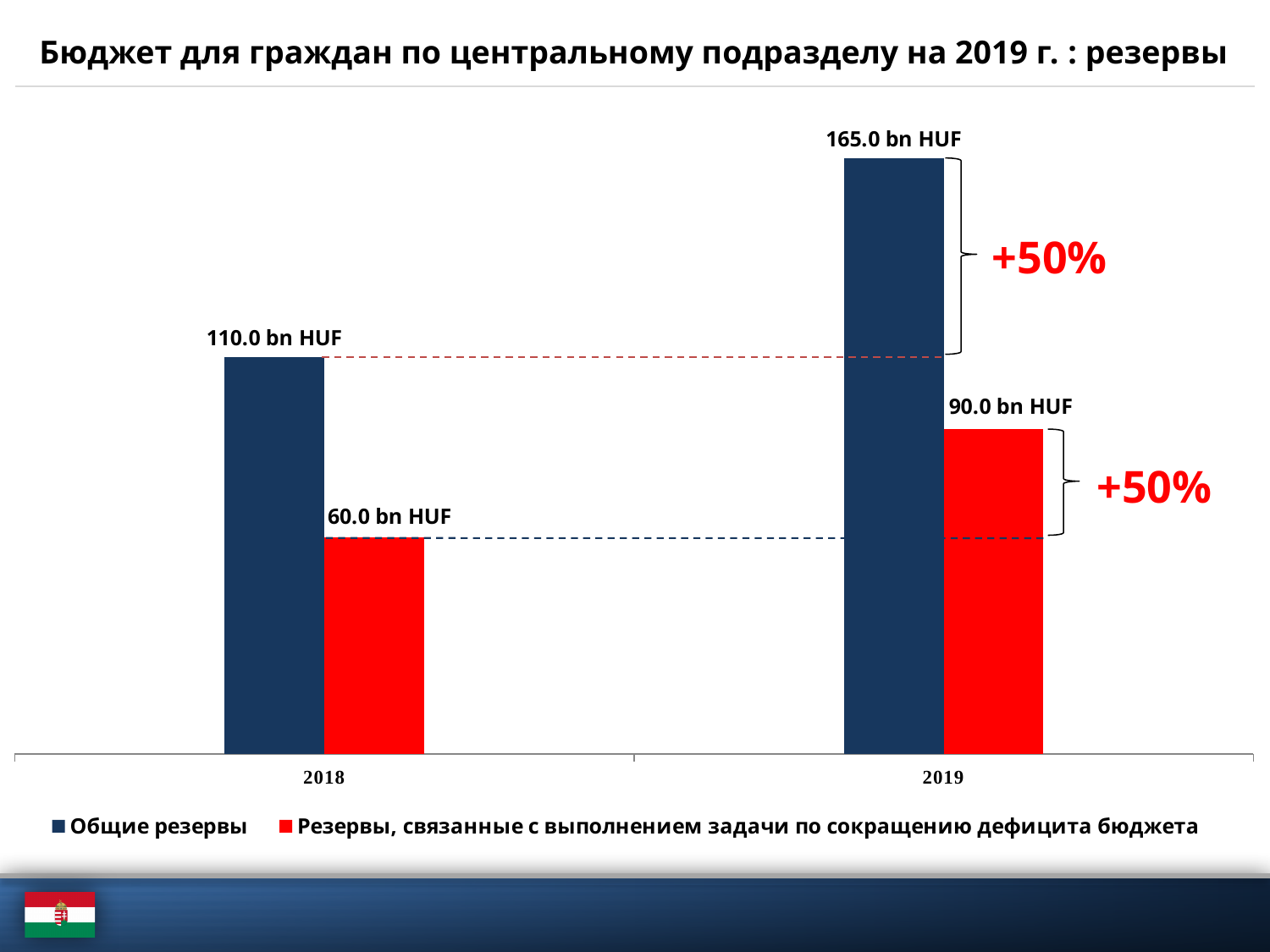
What is the value of Резервы, связанные с выполнением задачи по сокращению дефицита бюджета for 2018? 60.0 bn HUF What percentage increase is annotated next to the 2019 bars? +50% How many years are shown on the x axis? 2 What is the value of Резервы, связанные с выполнением задачи по сокращению дефицита бюджета for 2019? 90.0 bn HUF Which year has the higher value for Общие резервы? 2019 Do the values for Резервы, связанные с выполнением задачи по сокращению дефицита бюджета rise or fall from 2018 to 2019? rise What is the difference between Общие резервы and Резервы, связанные с выполнением задачи по сокращению дефицита бюджета in 2019? 75.0 bn HUF By how much did Общие резервы increase from 2018 to 2019? 55.0 bn HUF What kind of chart is shown on the slide? bar chart How many series does the legend list? 2 What is the value of Общие резервы for 2018? 110.0 bn HUF What is the value of Общие резервы for 2019? 165.0 bn HUF